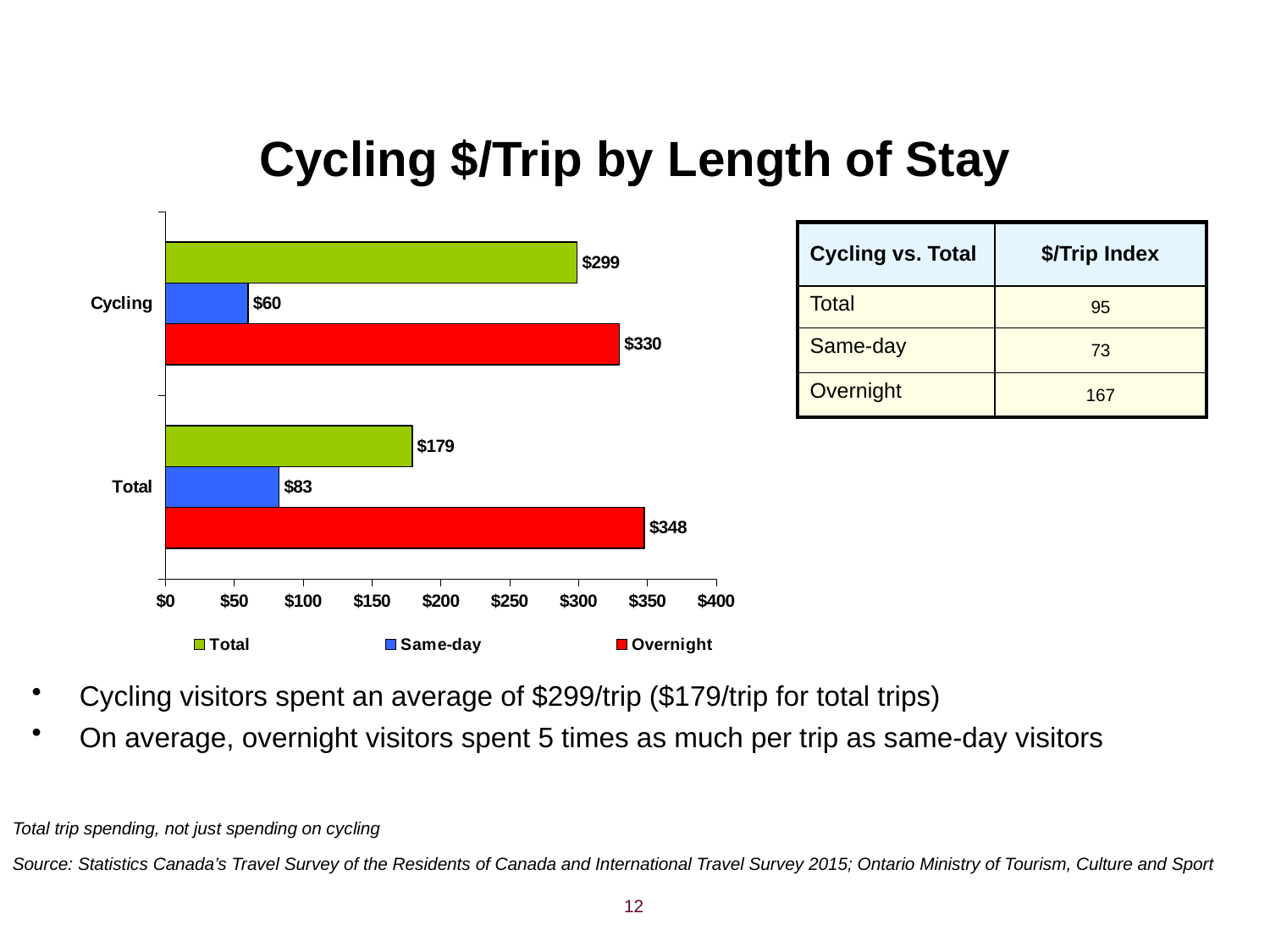
What is the difference between the Overnight values for Total and Cycling? $18 What is the Total series value for Cycling? $299 What is the Overnight value for Cycling? $330 Is the Total series value for Cycling greater or less than $250? greater What is the Same-day value for Total? $83 What kind of chart is shown? bar chart Which series has the lowest value for the Cycling category? Same-day What colour represents the Overnight series? red How many categories are shown on the y axis? 2 Which is larger, the Same-day value for Cycling or the Same-day value for Total? Total How many series does the legend list? 3 Which series has the highest value for the Total category? Overnight